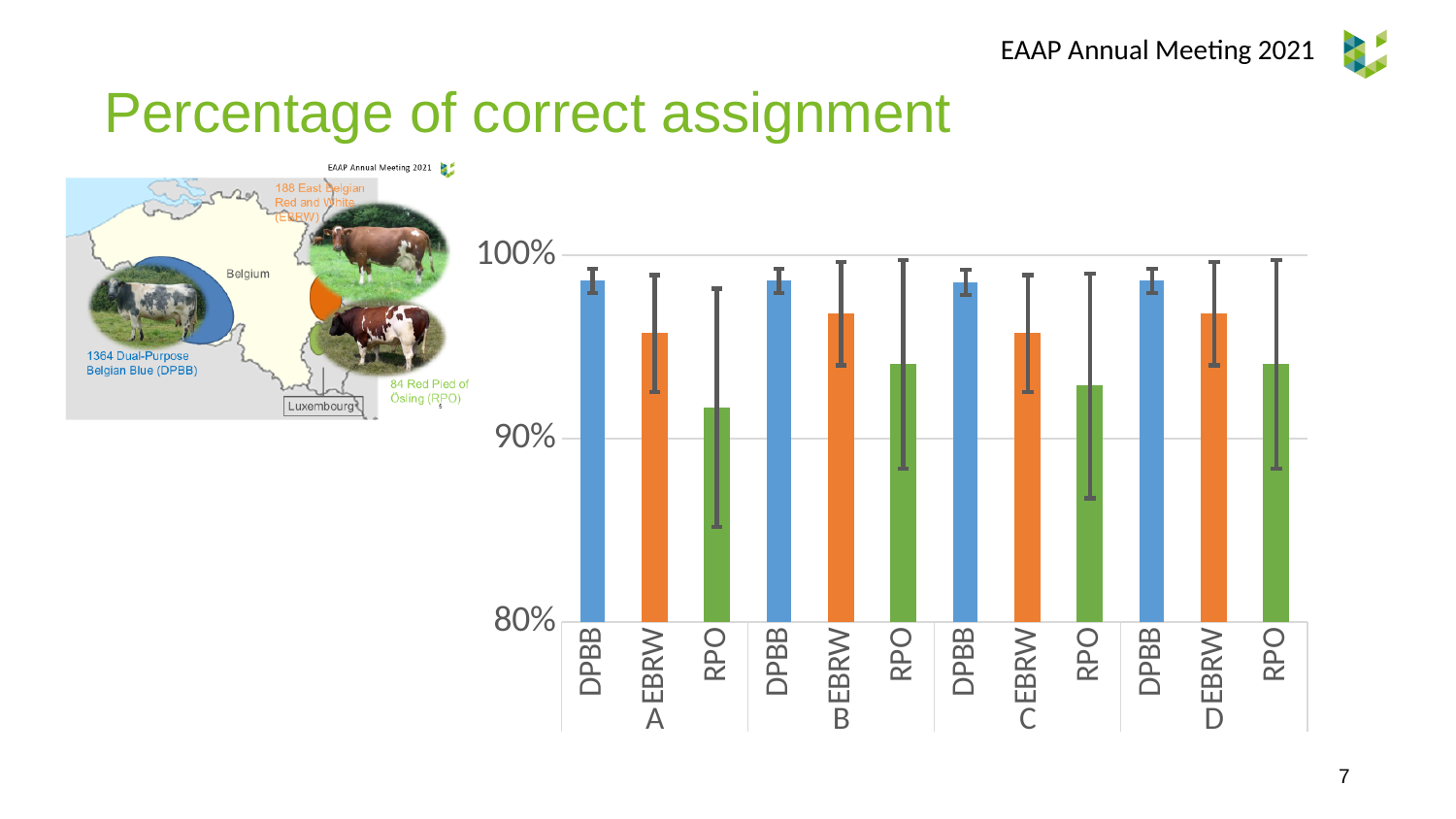
How many bars are plotted in the chart? 12 What colour are the RPO bars in the chart? green What is the title of the slide containing the chart? Percentage of correct assignment In group C, which is larger, the value for EBRW or the value for RPO? EBRW How many groups (A, B, C, D) are shown along the x axis of the chart? 4 In group B, which is larger, the value for DPBB or the value for EBRW? DPBB Which breed has the lowest bar in the chart? RPO in group A Is the value for DPBB in group A greater or less than 90%? greater Is the value for RPO in group A greater or less than 90%? greater What kind of chart is shown on the slide? bar chart In group A, which is larger, the value for DPBB or the value for RPO? DPBB Is the value for EBRW in group B greater or less than 100%? less